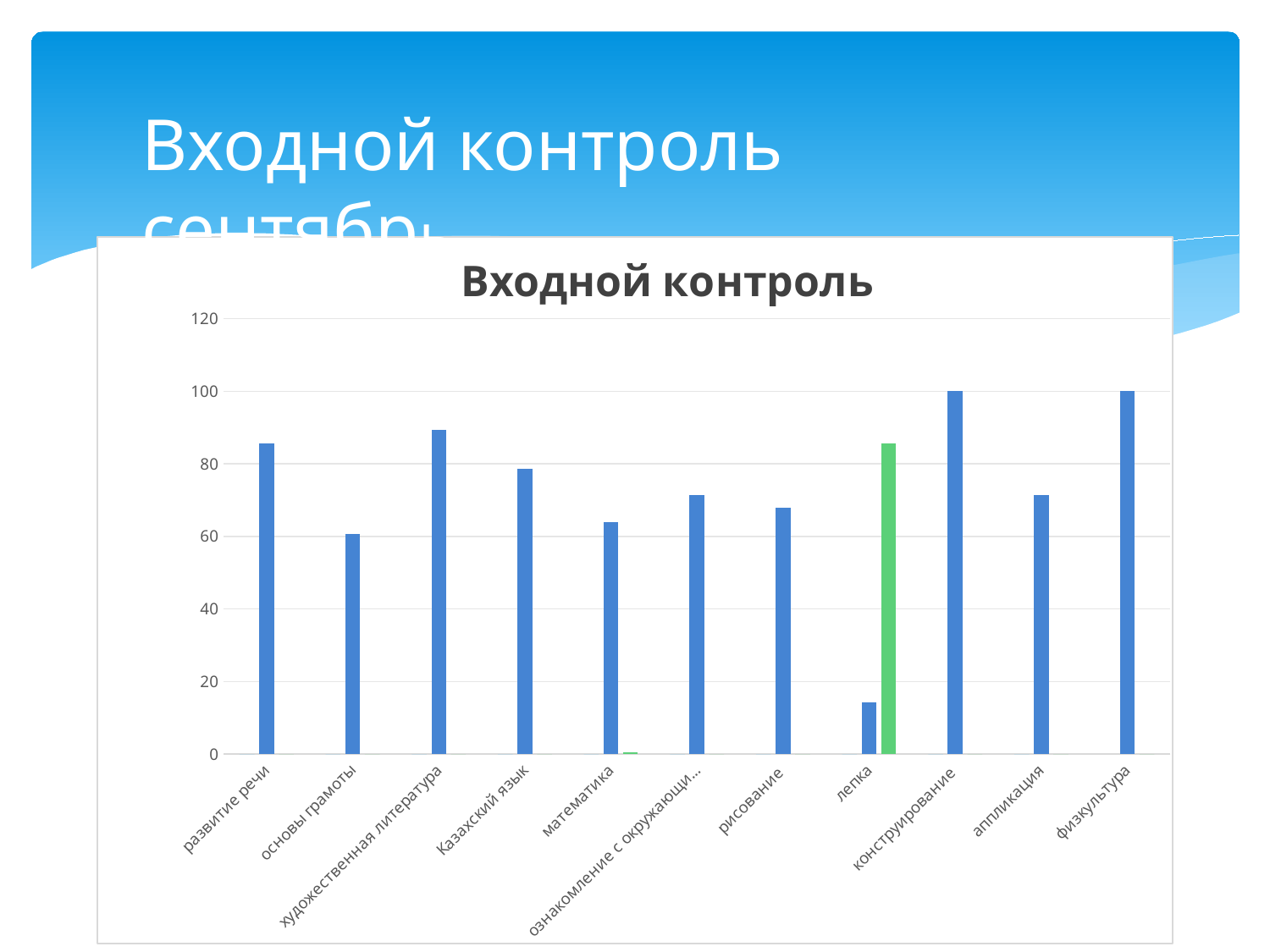
Is the value for основы грамоты greater or less than 80? less Which category has the lowest blue bar? лепка What is the title of the chart? Входной контроль What is the value for физкультура? 100 Is the blue bar for лепка greater or less than 20? less Which is larger, the value for художественная литература or the value for основы грамоты? художественная литература Is the value for математика greater or less than 60? greater What kind of chart is shown on the slide? bar chart How many categories are shown on the x axis of the chart? 11 What is the value for конструирование? 100 Which is larger, the value for Казахский язык or the value for математика? Казахский язык